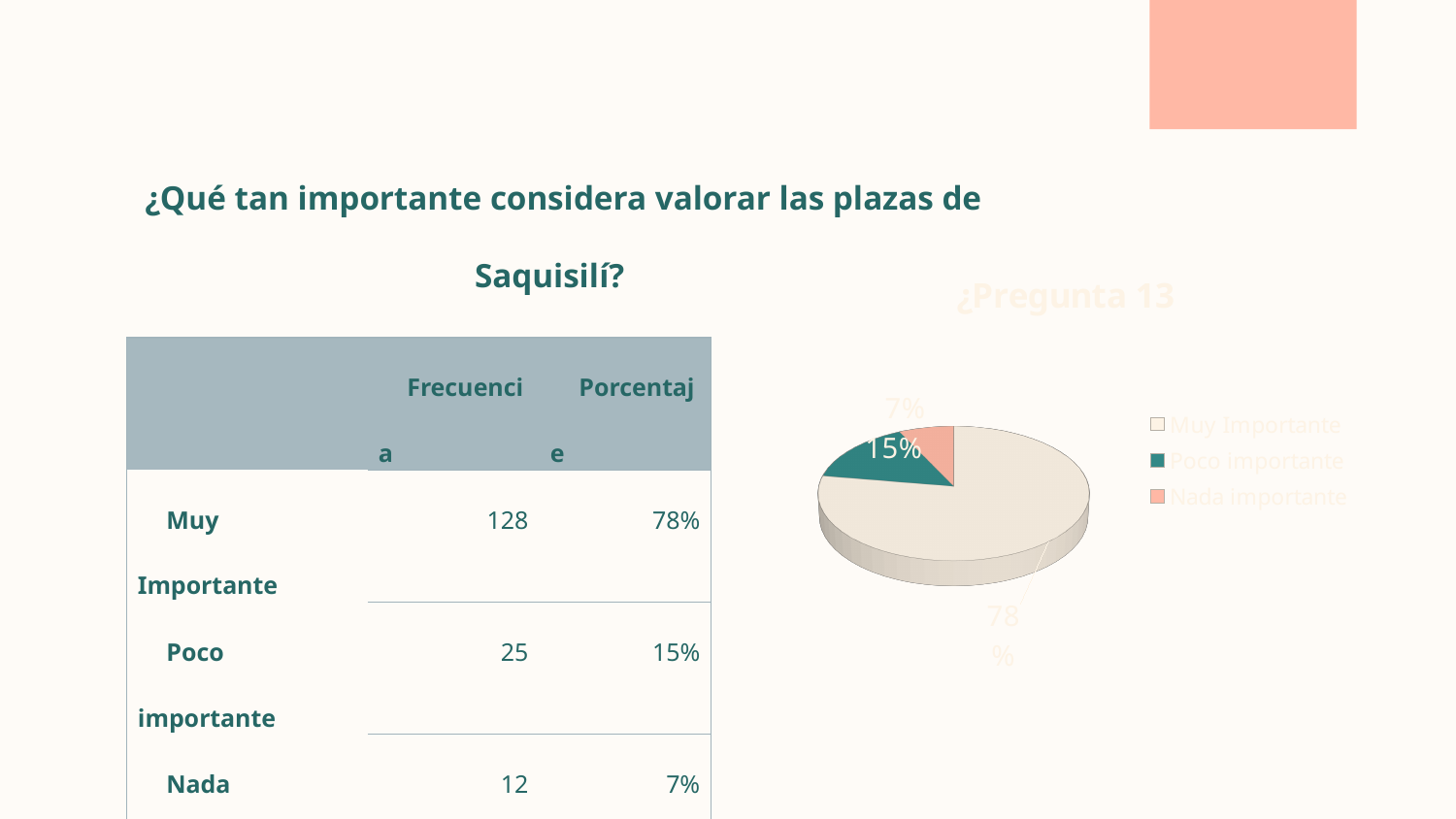
What share of the pie does the Muy Importante slice represent? 78% How many slices does the pie chart have? 3 What share of the pie does the Nada importante slice represent? 7% Which category has the smallest slice in the pie chart? Nada importante Which legend entry is shown in salmon/pink in the pie chart? Nada importante How many entries does the pie chart's legend list? 3 Which slice is larger in the pie chart, Poco importante or Nada importante? Poco importante What is the difference in percentage points between the Muy Importante slice and the Poco importante slice? 63 Which category has the largest slice in the pie chart? Muy Importante Which legend entry is shown in teal in the pie chart? Poco importante What share of the pie does the Poco importante slice represent? 15% What kind of chart is shown on the slide? pie chart